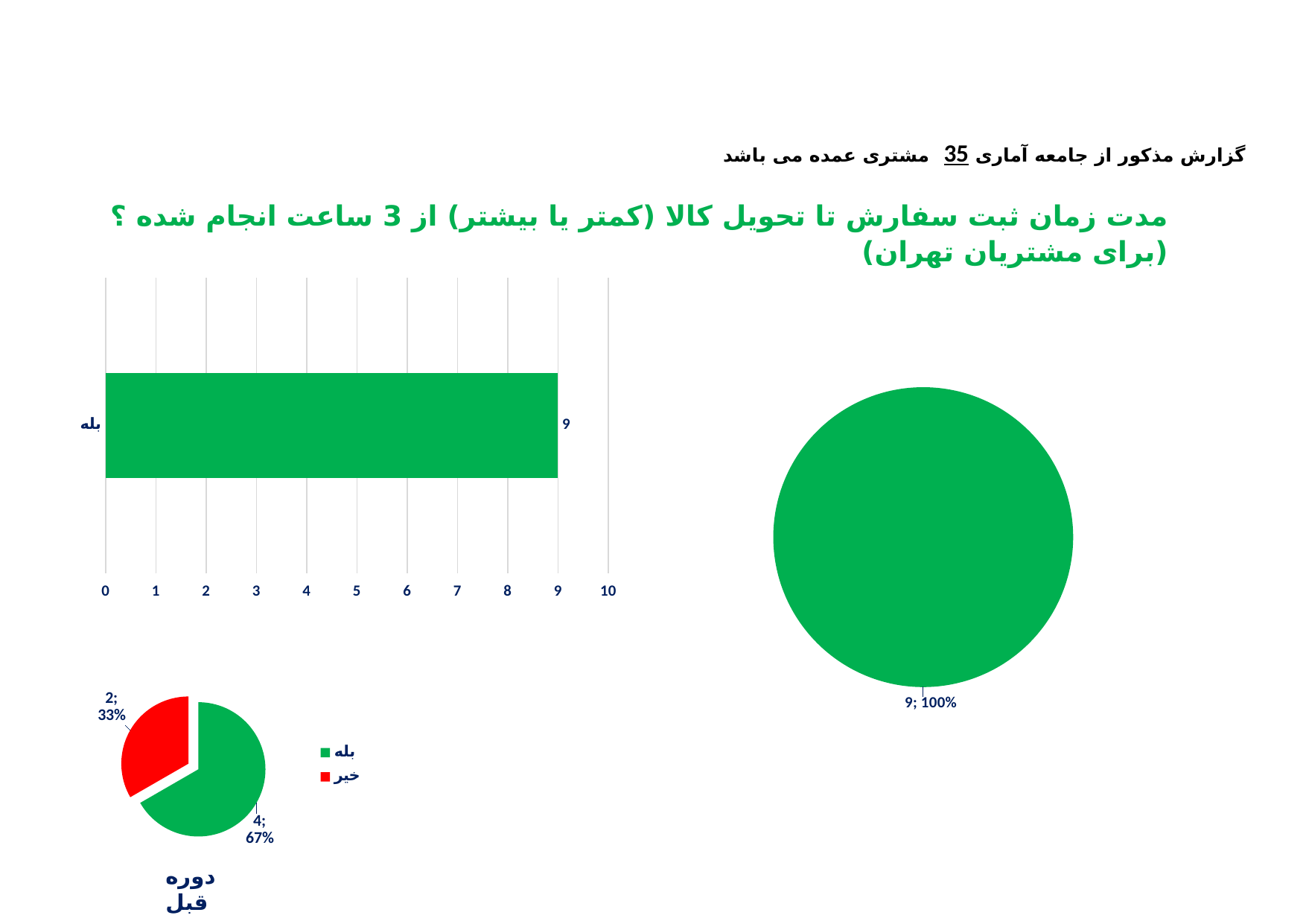
In the large pie chart on the right, what value is printed on the slice? 9 In the bar chart on the top left, what is the value of the bar labelled بله? 9 In the bar chart on the top left, is the value for بله greater or less than 5? greater In the small pie chart labelled دوره قبل at the bottom left, what value is printed on the green slice (بله)? 4 In the small pie chart labelled دوره قبل at the bottom left, what share does the red slice (خیر) represent? 33% In the large pie chart on the right, what share of the pie does the single slice represent? 100% In the small pie chart labelled دوره قبل at the bottom left, what is the difference between the values of بله and خیر? 2 How many bars does the bar chart on the top left have? 1 What kind of chart is the large chart on the right of the slide? pie chart In the small pie chart labelled دوره قبل at the bottom left, which slice is larger, بله or خیر? بله How many entries does the legend next to the small pie chart at the bottom left list? 2 What kind of chart is the chart on the top left of the slide? bar chart